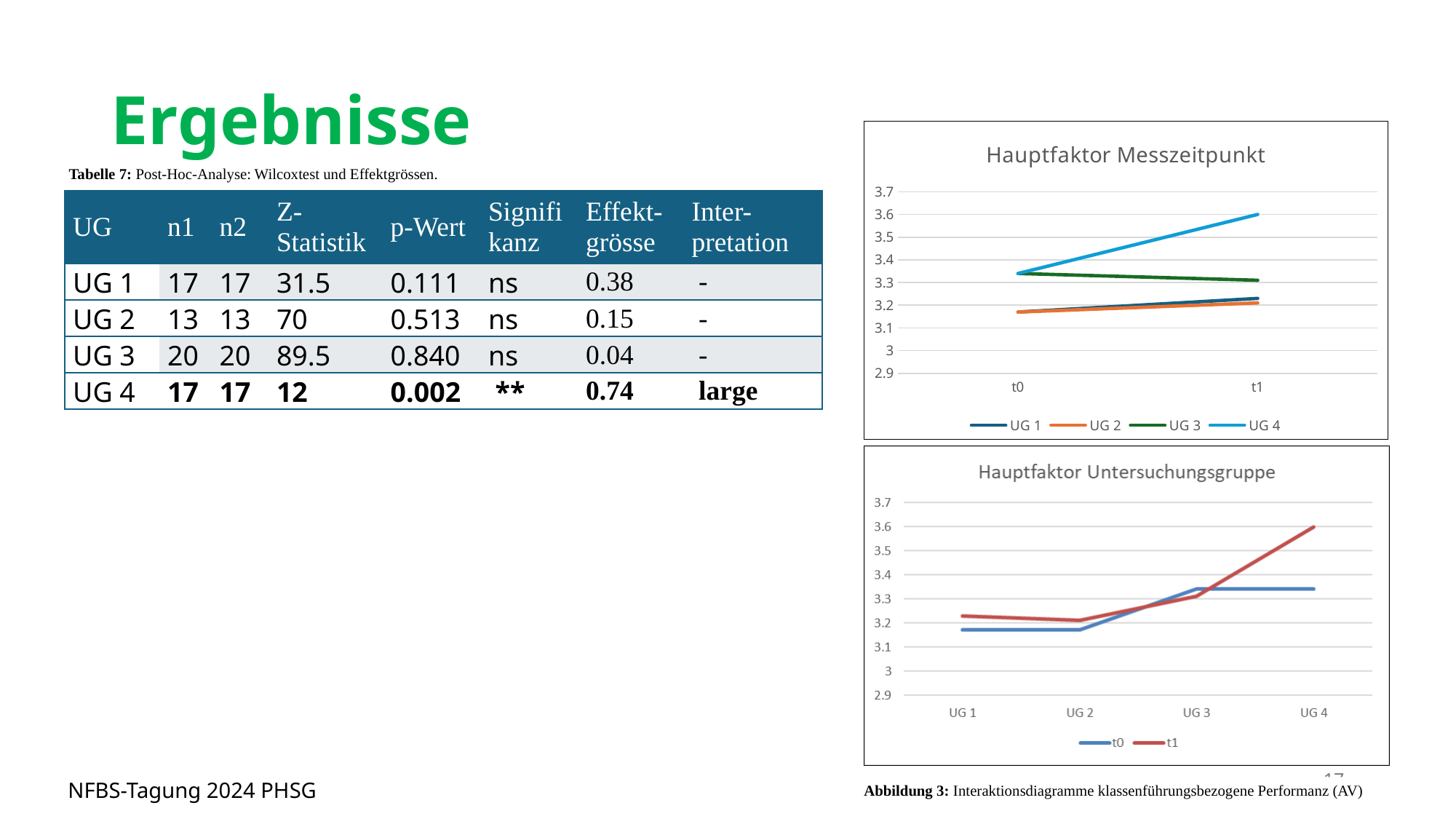
How many points are on the x axis of the "Hauptfaktor Messzeitpunkt" chart? 2 In the "Hauptfaktor Messzeitpunkt" chart, is the value for UG 4 at t1 greater or less than 3.5? greater In the "Hauptfaktor Messzeitpunkt" chart, which series has the highest value at t1? UG 4 In the "Hauptfaktor Messzeitpunkt" chart, is the value for UG 2 at t0 greater or less than 3.2? less In the "Hauptfaktor Untersuchungsgruppe" chart, which category has the highest t1 value? UG 4 How many categories are on the x axis of the "Hauptfaktor Untersuchungsgruppe" chart? 4 In the "Hauptfaktor Messzeitpunkt" chart, does the UG 4 line rise or fall from t0 to t1? rise In the "Hauptfaktor Untersuchungsgruppe" chart, which is larger for UG 4: the t0 value or the t1 value? t1 What kind of chart is the "Hauptfaktor Messzeitpunkt" chart? line chart How many series does the legend of the "Hauptfaktor Messzeitpunkt" chart list? 4 In the "Hauptfaktor Messzeitpunkt" chart, does the UG 3 line rise or fall from t0 to t1? fall How many series does the legend of the "Hauptfaktor Untersuchungsgruppe" chart list? 2